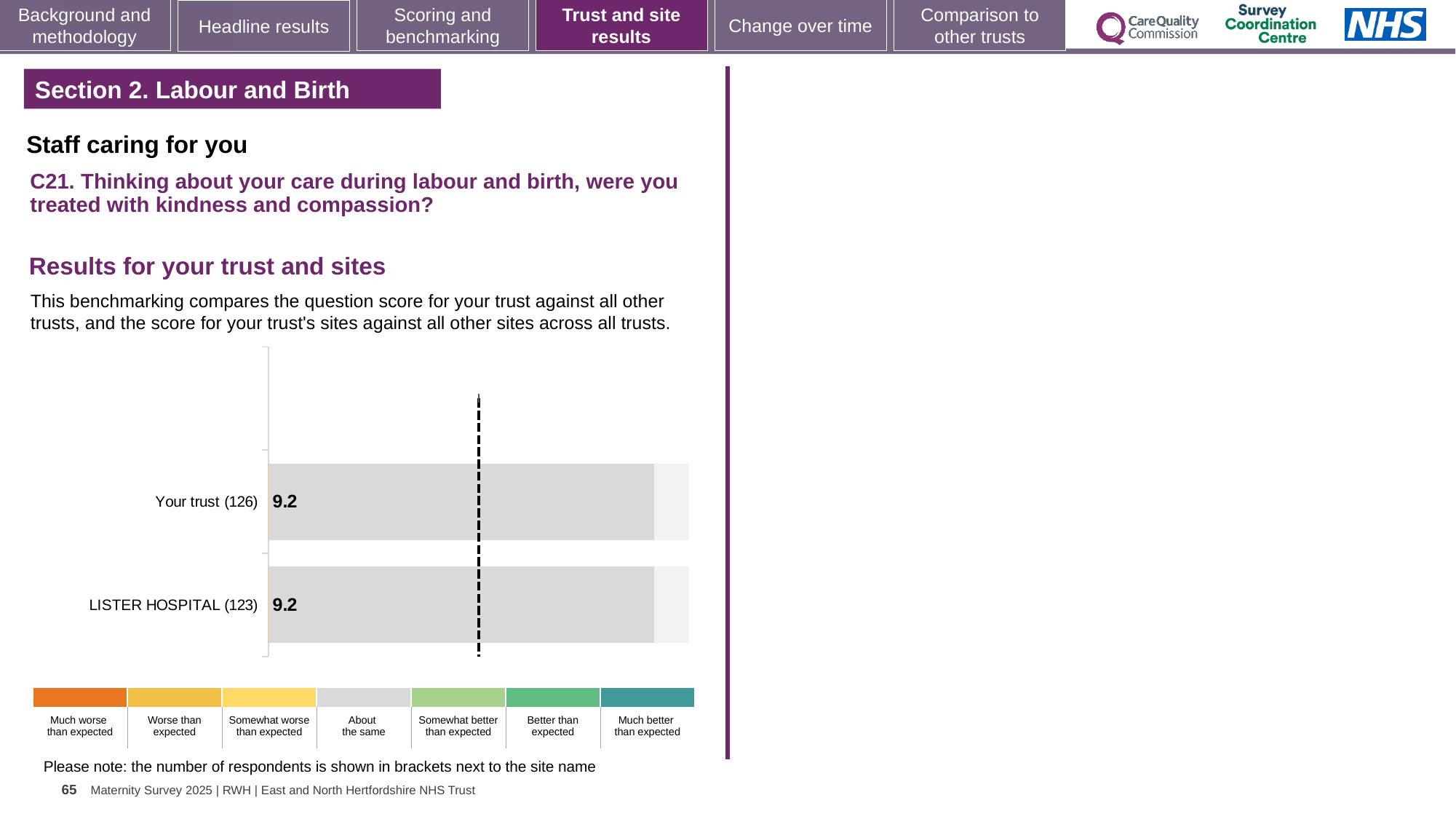
Which site is listed below Your trust in the chart? LISTER HOSPITAL (123) How many respondents are shown in brackets for LISTER HOSPITAL? 123 Is the score for Your trust higher than, lower than, or equal to the score for LISTER HOSPITAL? equal What is the difference between the score for Your trust and the score for LISTER HOSPITAL? 0 What is the score for LISTER HOSPITAL (123)? 9.2 What is the score for Your trust (126)? 9.2 How many bars are plotted in the chart? 2 What kind of chart is shown on the slide? bar chart How many respondents are shown in brackets for Your trust? 126